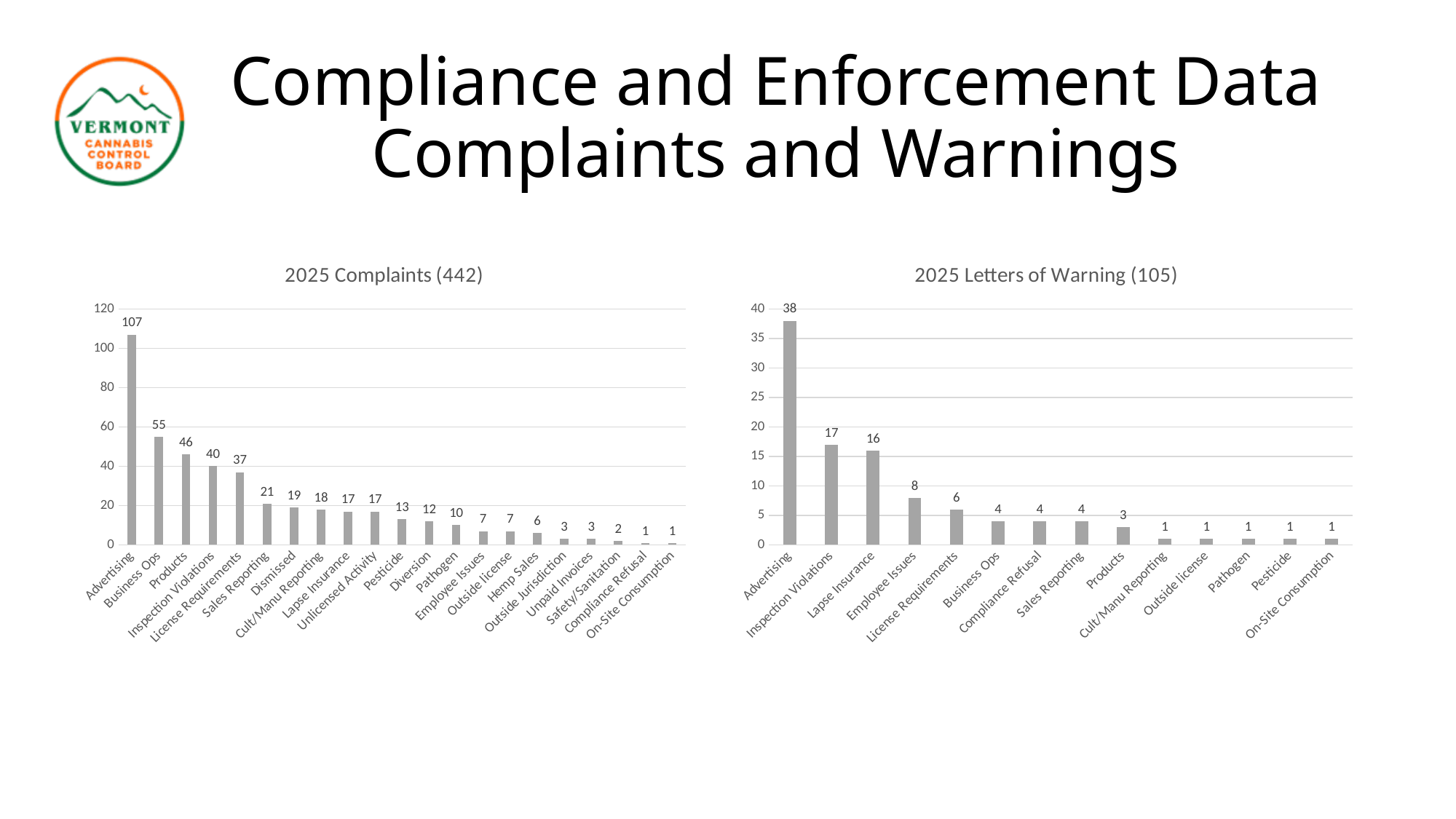
In the 2025 Complaints chart, how many categories are shown on the x axis? 21 In the 2025 Complaints chart, which is larger, Products or Inspection Violations? Products In the 2025 Letters of Warning chart, which category has the highest value? Advertising In the 2025 Letters of Warning chart, what is the difference between Advertising and Inspection Violations? 21 In the 2025 Complaints chart, what is the value for Sales Reporting? 21 In the 2025 Complaints chart, how many complaints were there for Business Ops? 55 In the 2025 Letters of Warning chart, how many categories are shown on the x axis? 14 What type of chart is the 2025 Letters of Warning chart? Bar chart In the 2025 Letters of Warning chart, what is the value for Employee Issues? 8 In the 2025 Complaints chart, which category has the highest value? Advertising In the 2025 Letters of Warning chart, what is the value for Lapse Insurance? 16 In the 2025 Complaints chart, what is the difference between Advertising and Business Ops? 52